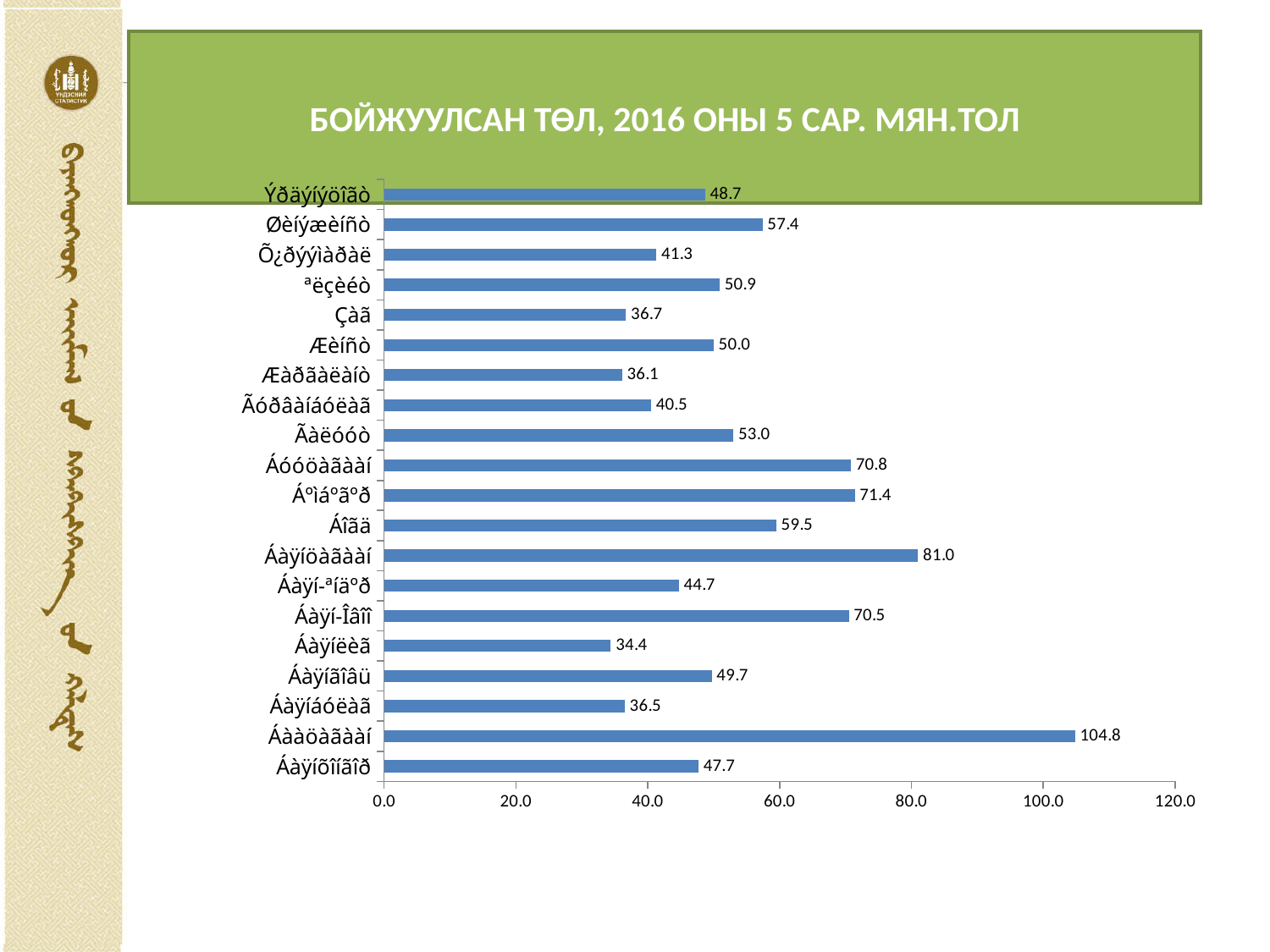
What is the value of the longest bar in the chart (the second bar from the bottom)? 104.8 What is the difference between the longest bar (104.8) and the second-longest bar (81.0)? 23.8 How many categories (bars) are plotted in the chart? 20 What is the value of the bottom bar in the chart? 47.7 What is the value of the bar labelled Ãàëóóò? 53.0 Which is larger: the bar labelled Áóóöàãààí (70.8) or the bar labelled Áºìáºãºð (71.4)? Áºìáºãºð (71.4) What is the value of the shortest bar in the chart? 34.4 Is the value of the longest bar greater or less than 100.0? greater What type of chart is shown on the slide? bar chart What is the title of the chart? БОЙЖУУЛСАН ТӨЛ, 2016 ОНЫ 5 САР. МЯН.ТОЛ What is the value of the topmost bar in the chart? 48.7 What is the value of the bar labelled Áàÿíöàãààí? 81.0